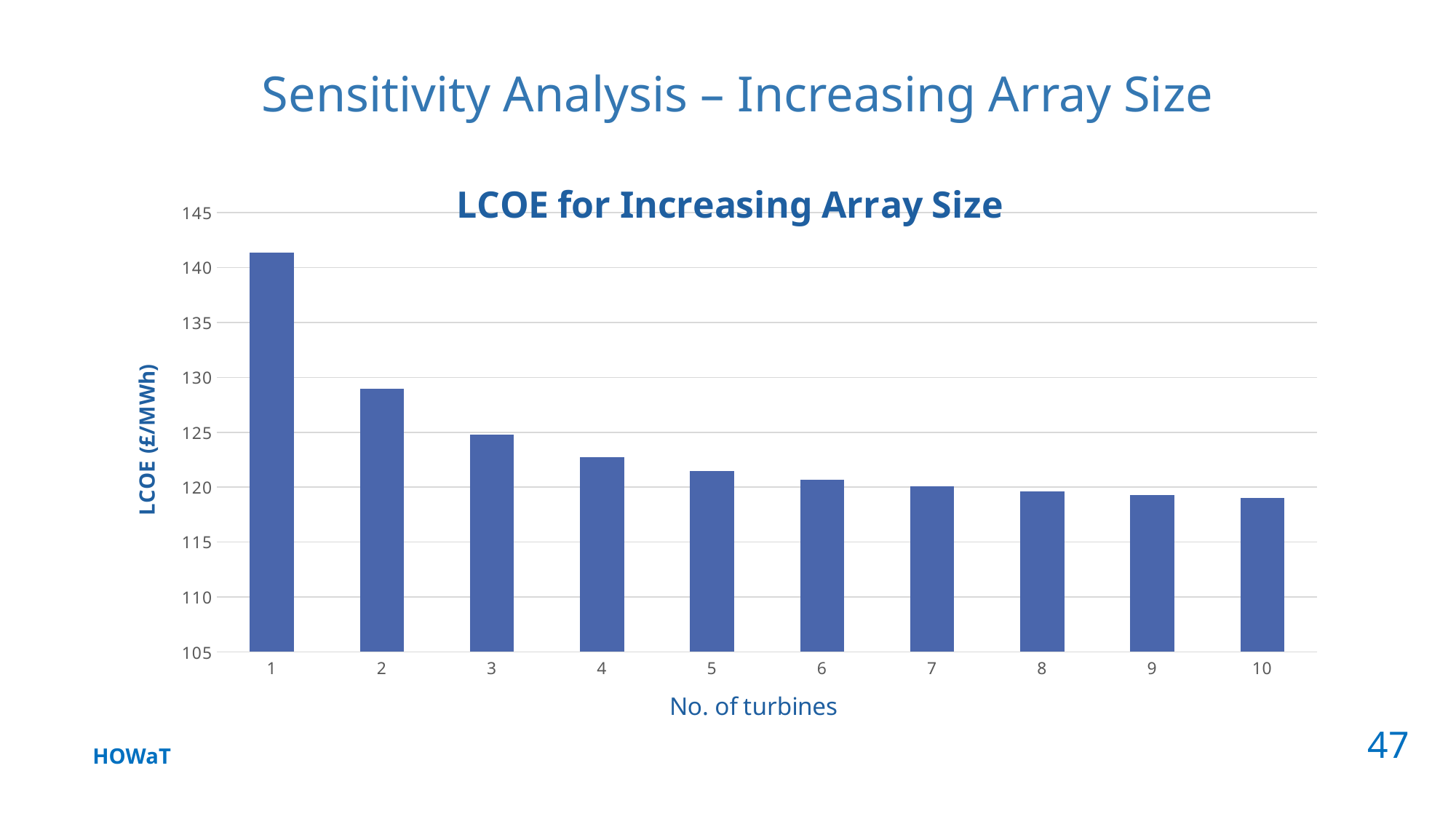
Do the LCOE values rise or fall as the number of turbines increases? fall Is the LCOE for 2 turbines greater or less than 130? less Is the LCOE for 10 turbines greater or less than 115? greater Is the LCOE for 4 turbines greater or less than 120? greater How many bars (numbers of turbines) are plotted in the chart? 10 What is the label of the vertical axis? LCOE (£/MWh) Which number of turbines has the highest LCOE? 1 What is the title of the chart? LCOE for Increasing Array Size What kind of chart is shown on the slide? bar chart Which has the larger LCOE, 2 turbines or 5 turbines? 2 turbines